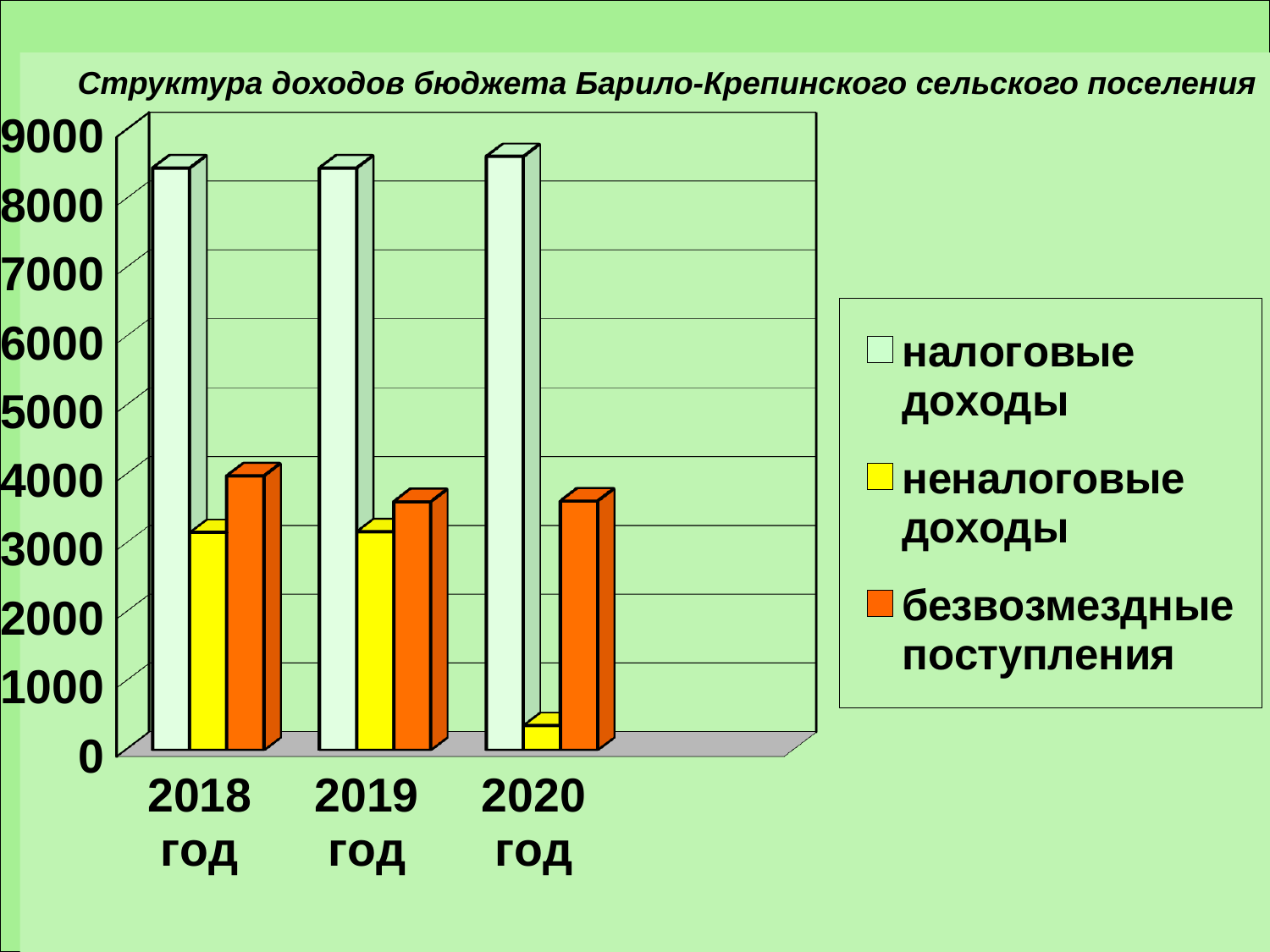
Which series has the lowest value in 2020 год? неналоговые доходы Which series is shown in yellow in the legend? неналоговые доходы How many year categories are shown on the x axis? 3 How many series does the legend list? 3 In 2020 год, which is larger: неналоговые доходы or безвозмездные поступления? безвозмездные поступления Is the value for неналоговые доходы in 2018 год greater or less than 4000? less Is the value for налоговые доходы in 2018 год greater or less than 8000? greater What kind of chart is shown on the slide? bar chart Is the value for неналоговые доходы in 2020 год greater or less than 1000? less Do the values for неналоговые доходы rise or fall from 2019 год to 2020 год? fall Which series has the highest value in 2020 год? налоговые доходы